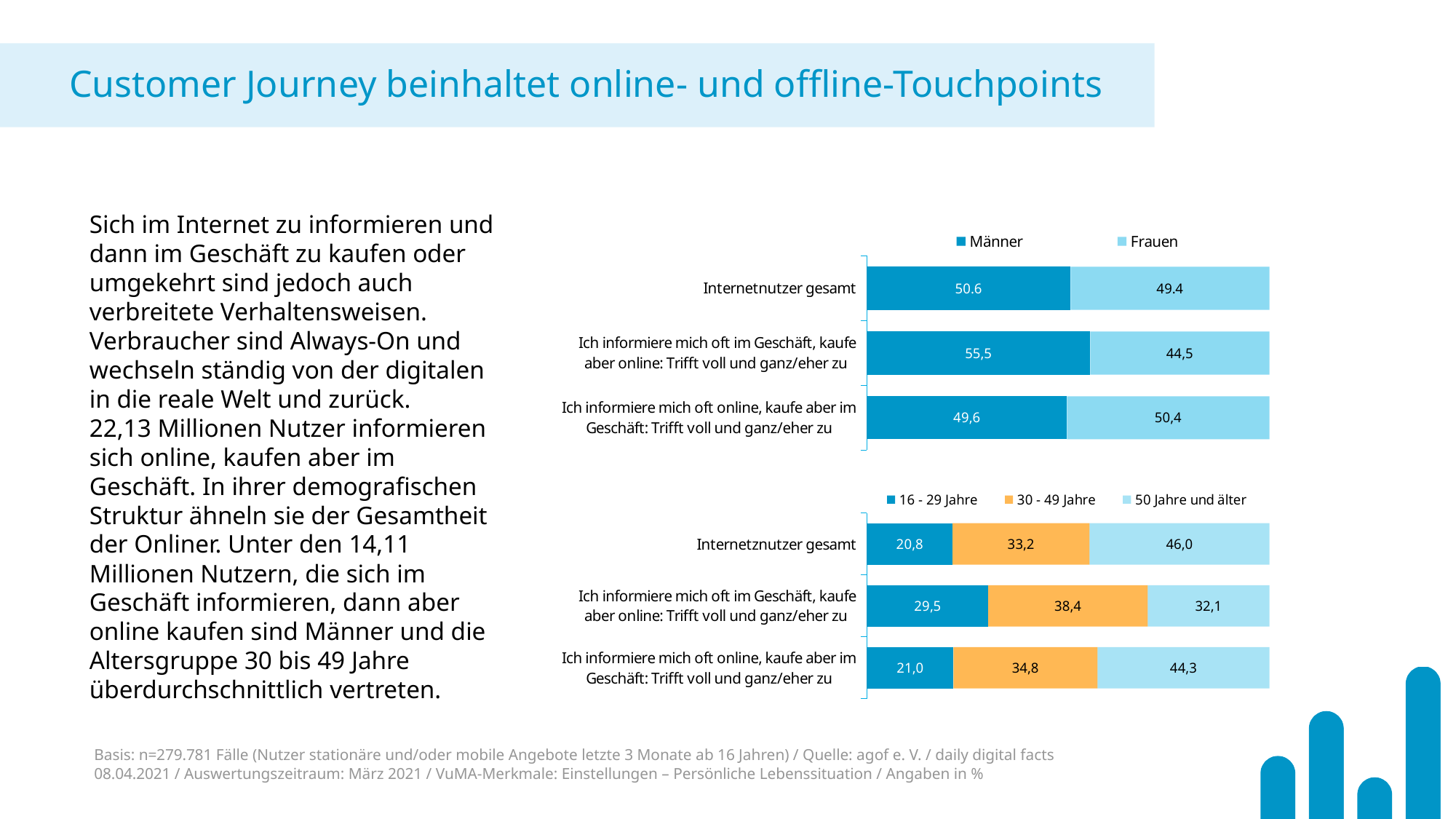
In the bottom chart, which is larger for 'Ich informiere mich oft online, kaufe aber im Geschäft': the '30 - 49 Jahre' value or the '50 Jahre und älter' value? 50 Jahre und älter What kind of chart is the bottom chart? Stacked bar chart In the top chart, what is the Männer value for 'Internetnutzer gesamt'? 50.6 In the top chart, what is the Männer value for 'Ich informiere mich oft im Geschäft, kaufe aber online'? 55,5 In the bottom chart, what is the '30 - 49 Jahre' value for 'Ich informiere mich oft im Geschäft, kaufe aber online'? 38,4 In the bottom chart, what is the '50 Jahre und älter' value for 'Internetznutzer gesamt'? 46,0 In the bottom chart, which category has the highest '16 - 29 Jahre' value? Ich informiere mich oft im Geschäft, kaufe aber online How many series does the legend of the bottom chart list? 3 In the top chart, what is the difference between the Männer and Frauen values for 'Ich informiere mich oft im Geschäft, kaufe aber online'? 11 In the top chart, what is the Frauen value for 'Ich informiere mich oft online, kaufe aber im Geschäft'? 50,4 How many series does the legend of the top chart list? 2 In the top chart, which category has the highest Männer value? Ich informiere mich oft im Geschäft, kaufe aber online